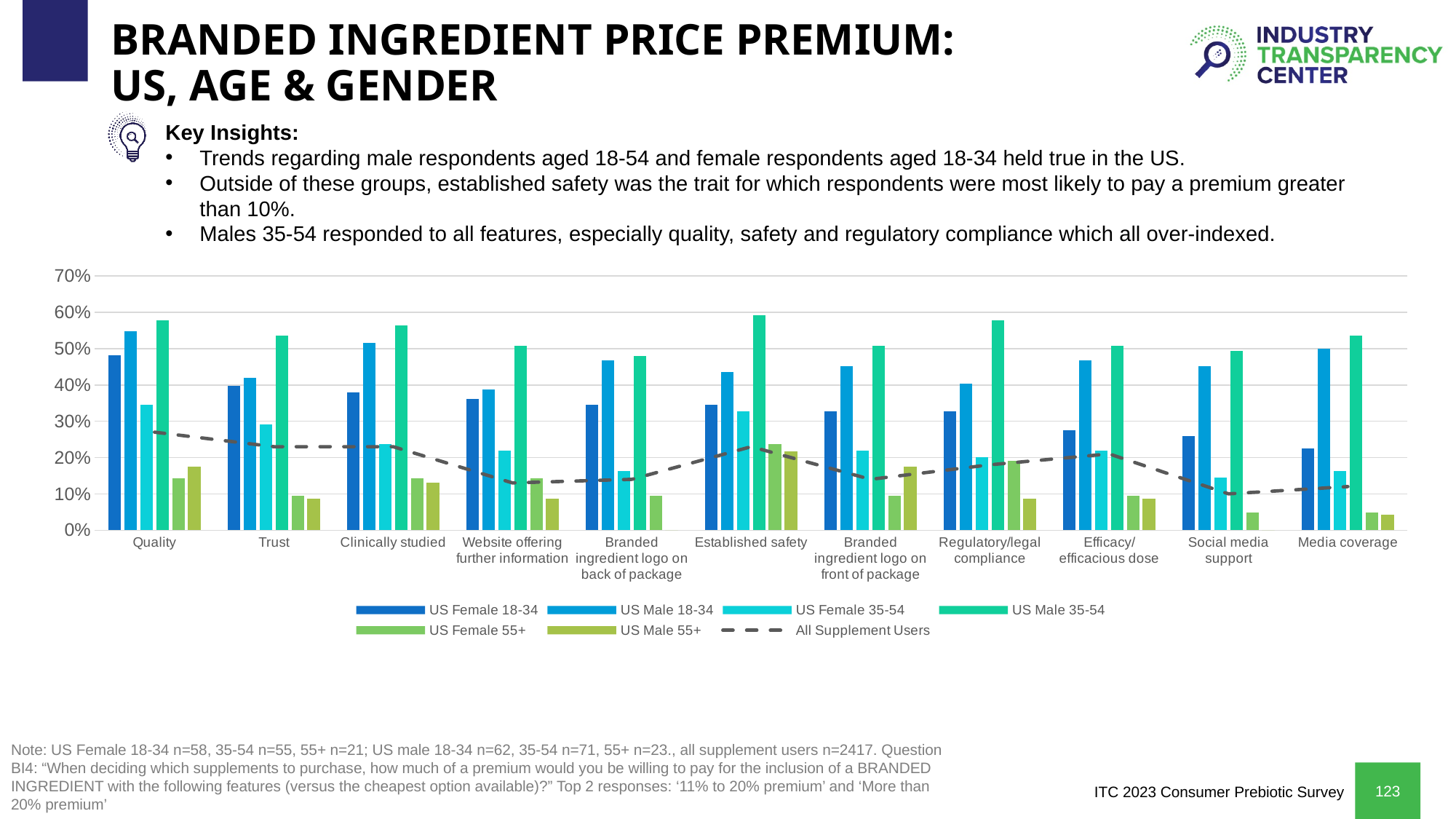
Is the value for US Male 18-34 in the Efficacy/efficacious dose category greater or less than 40%? greater How many categories are shown along the x axis of the chart? 11 How many series does the chart's legend list? 7 Is the value for US Female 35-54 in the Established safety category greater or less than 40%? less In the Quality category, which is larger: US Male 18-34 or US Female 18-34? US Male 18-34 Is the value for US Female 18-34 in the Quality category greater or less than 40%? greater In the Quality category, which series has the lowest value? US Female 55+ What kind of chart is shown on the slide? combination bar and line chart In the Trust category, which series has the highest value? US Male 35-54 Is the All Supplement Users line higher or lower at Media coverage than at Quality? lower